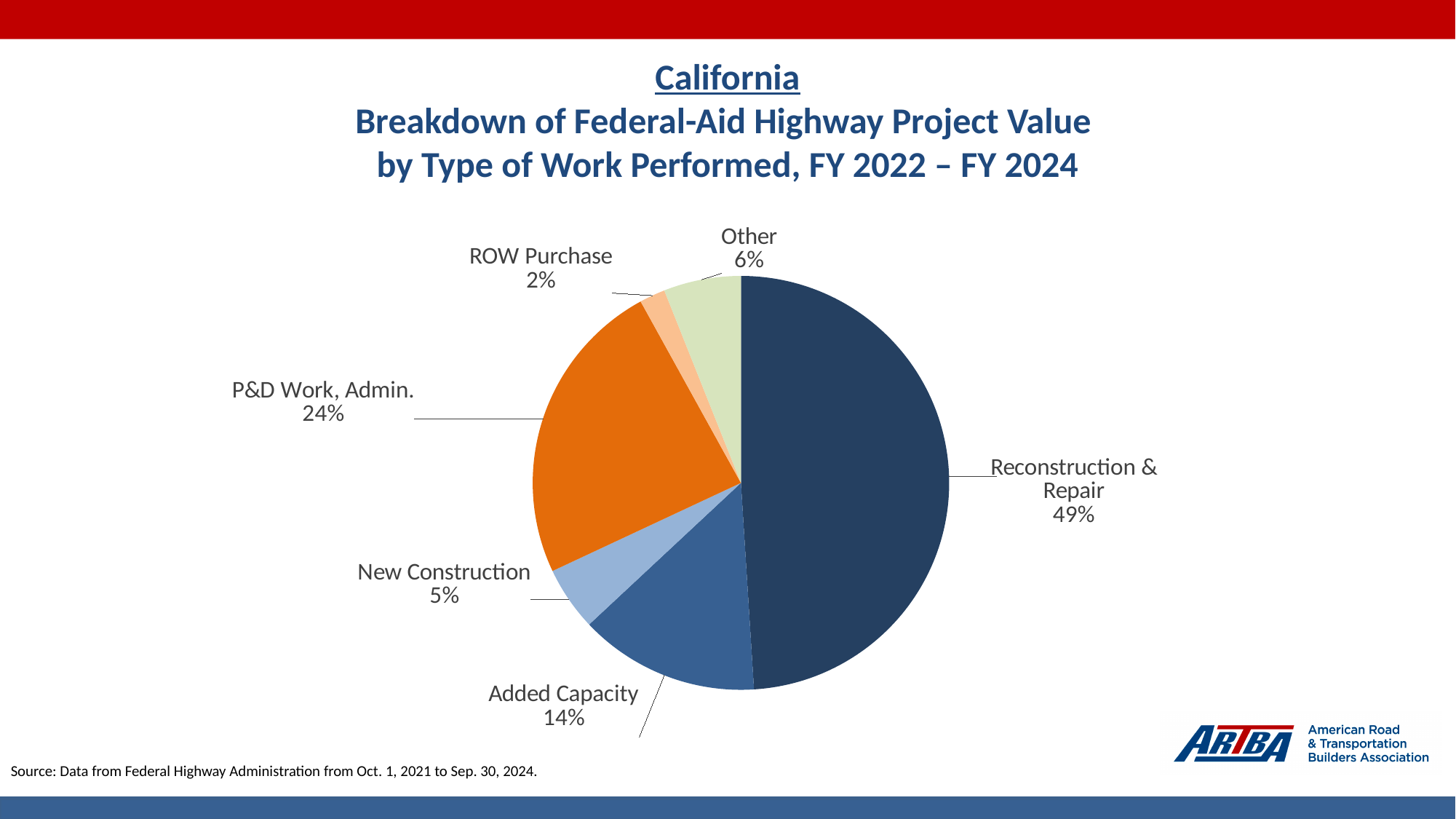
What percentage of the pie is P&D Work, Admin.? 24% How many slices does the pie chart have? 6 Which state does the chart cover? California What share of federal-aid highway project value in California is Reconstruction & Repair? 49% Which type of work has the smallest share of project value? ROW Purchase What percentage is shown for ROW Purchase? 2% What is the combined share of Added Capacity and New Construction? 19% Which has a larger share, New Construction or Other? Other What kind of chart is shown on the slide? Pie chart What share does Added Capacity represent? 14% Which type of work has the largest share of project value? Reconstruction & Repair What is the difference in percentage points between Reconstruction & Repair and P&D Work, Admin.? 25